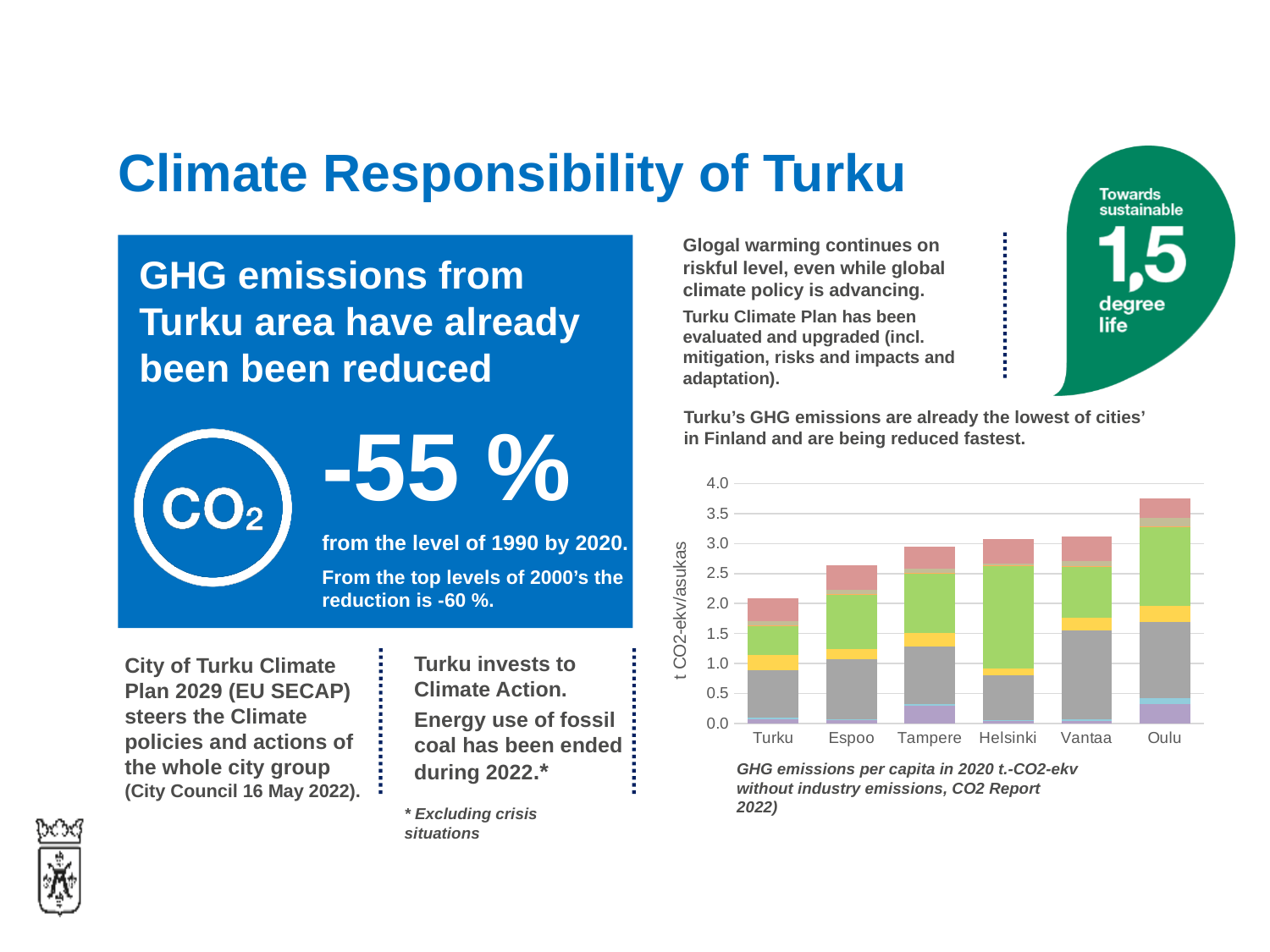
Which city has the lowest total GHG emissions per capita in the chart? Turku Is the total value for Oulu greater or less than 3.5? greater Is the total value for Turku greater or less than 2.5? less Which city has the highest total GHG emissions per capita in the chart? Oulu Is the total value for Tampere greater or less than 2.5? greater Which city is listed first on the x axis of the chart? Turku How many cities are shown on the x axis of the chart? 6 What is the label on the y axis of the chart? t CO2-ekv/asukas Do the total bar heights generally rise or fall from Turku on the left to Oulu on the right? rise What kind of chart is shown on the slide? stacked bar chart Which has a larger total bar, Espoo or Tampere? Tampere